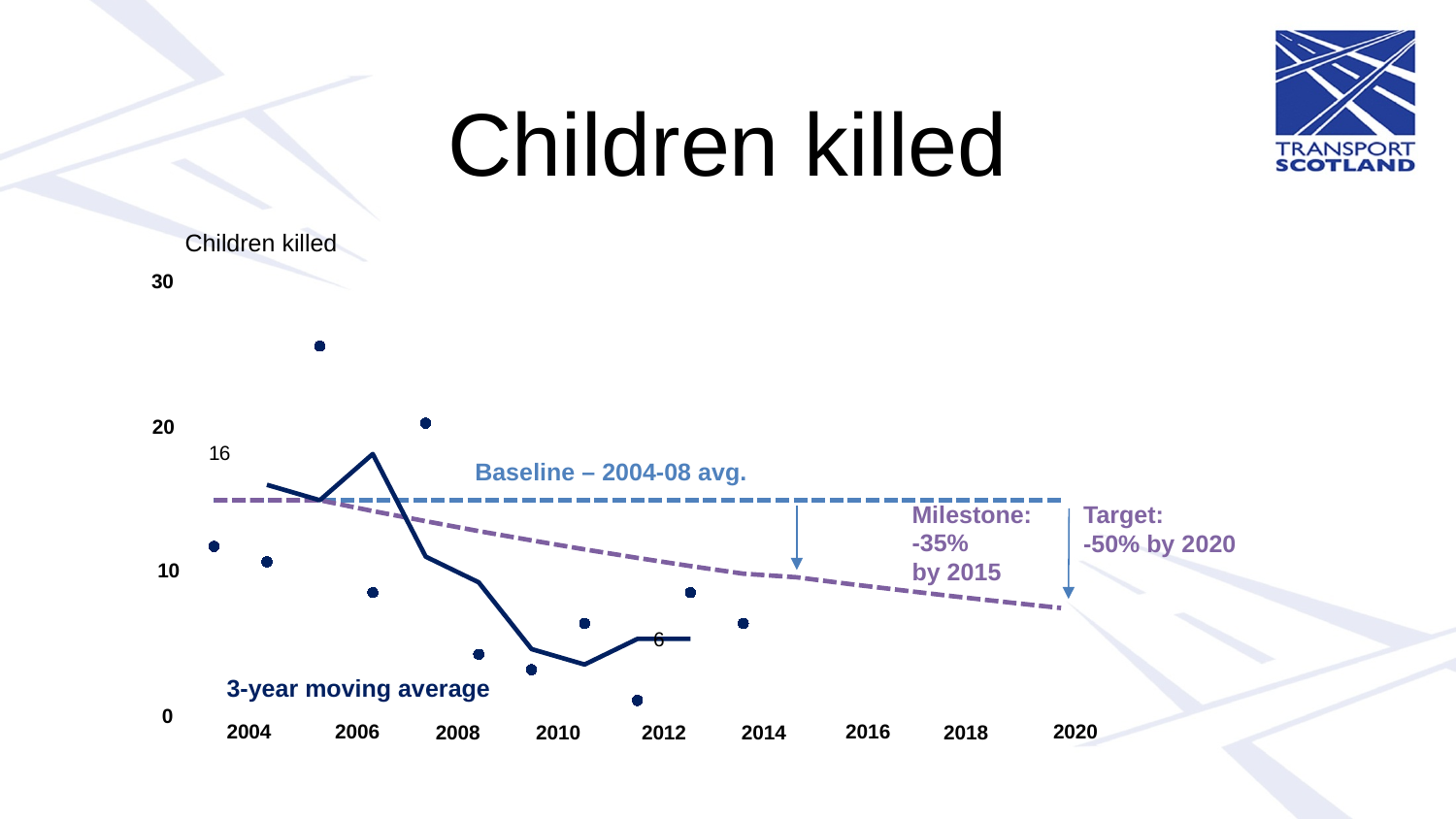
What value is labelled at the end of the 3-year moving average line? 6 What value is labelled at the start of the 3-year moving average line? 16 What is the target reduction by 2020 shown on the chart? -50% by 2020 In which year is the highest annual data point plotted? 2006 What is the title of the chart? Children killed Is the annual data point for 2012 greater or less than 10? less What period does the baseline dashed line represent, according to its label? 2004-08 avg. Does the 3-year moving average line rise or fall overall from 2004 to 2012? fall In which year is the lowest annual data point plotted? 2012 By how much does the labelled 3-year moving average fall from its first labelled value (16) to its last labelled value (6)? 10 What kind of chart is shown on the slide? line chart